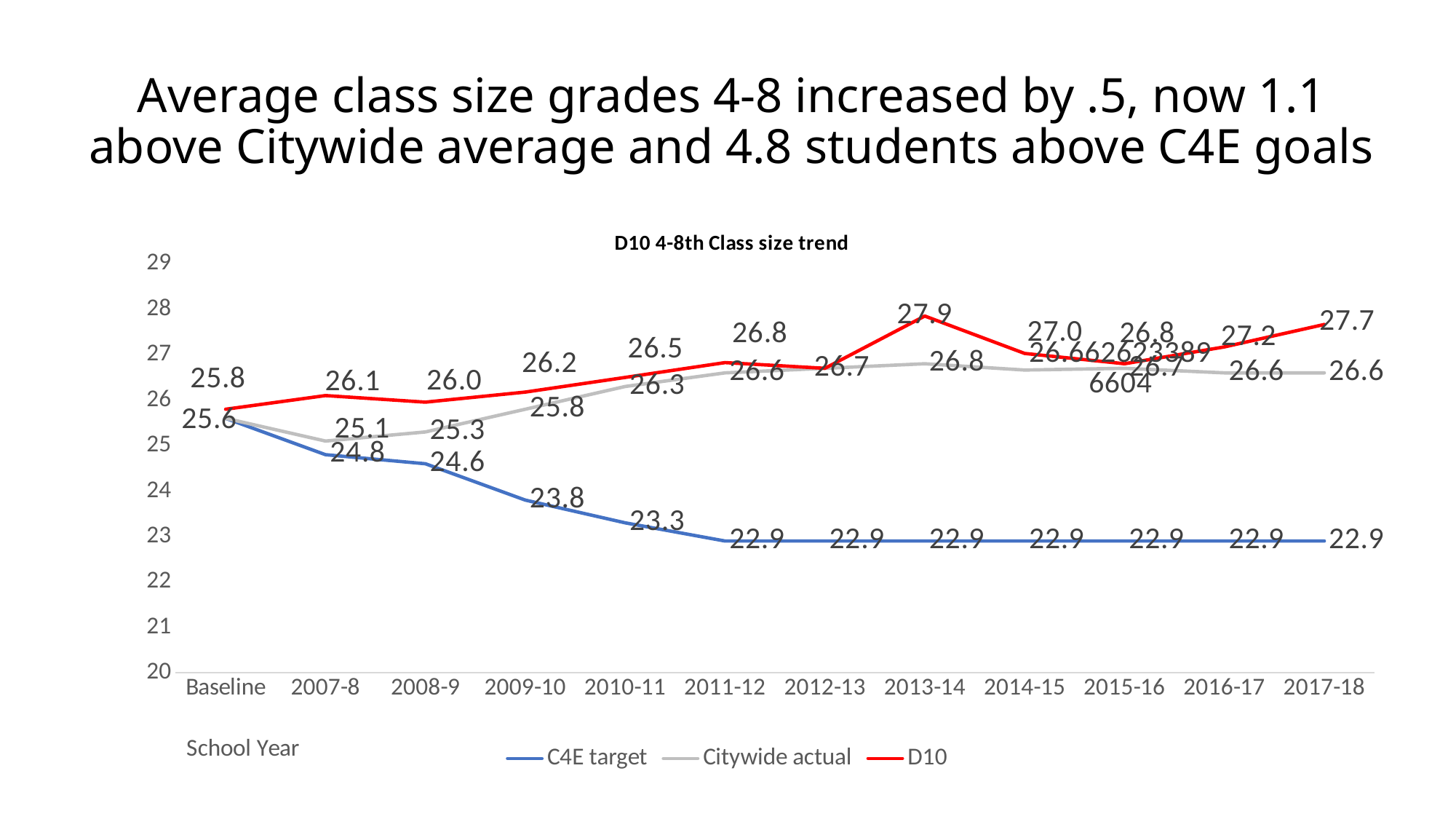
In which school year does the D10 line reach its highest value? 2013-14 What is the Citywide actual value for 2010-11? 26.3 How many school years are plotted on the x axis? 12 What is the C4E target value for 2009-10? 23.8 What kind of chart is shown on the slide? Line chart In 2017-18, which is larger: the D10 value or the Citywide actual value? D10 Does the C4E target line rise or fall from Baseline to 2011-12? Fall What is the D10 value for 2013-14? 27.9 What is the D10 value for 2017-18? 27.7 How many series does the legend list? 3 What is the difference between the D10 value and the C4E target value in 2017-18? 4.8 What colour is the D10 line in the legend? Red